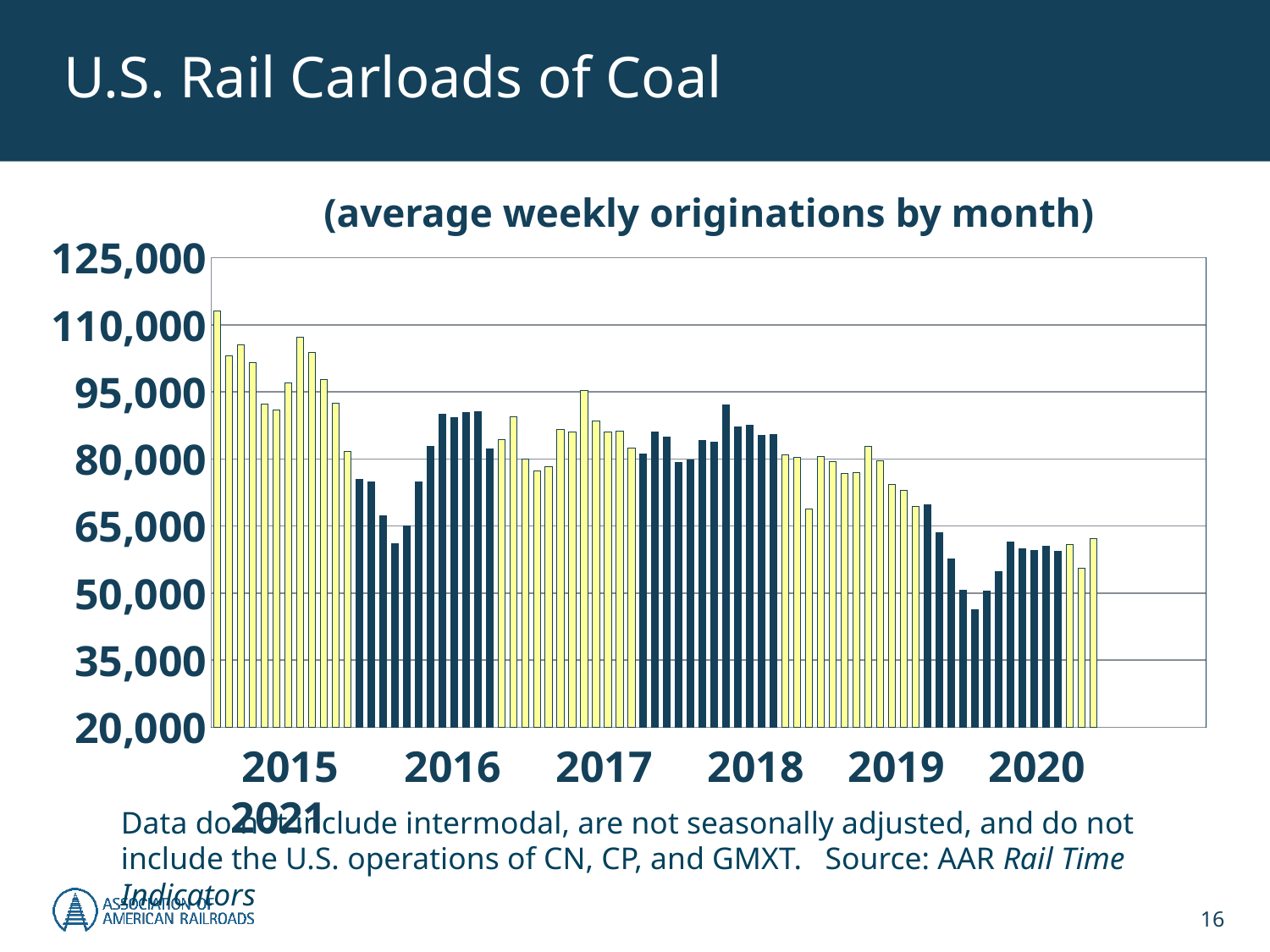
Overall, do the values rise or fall from 2015 to 2020? Fall In which year does the tallest bar on the chart appear? 2015 Which is larger, the tallest bar in 2015 or the tallest bar in 2020? The tallest bar in 2015 What is the subtitle shown above the chart? (average weekly originations by month) What is the highest value shown on the vertical axis? 125,000 Is the value of the first bar in 2016 greater or less than 80,000? less Are the values of the 2021 bars greater or less than 65,000? less How many year labels appear along the horizontal axis? 7 Is the value of the first bar in 2015 greater or less than 110,000? greater What kind of chart is shown on the slide? Bar chart In which year does the shortest bar on the chart appear? 2020